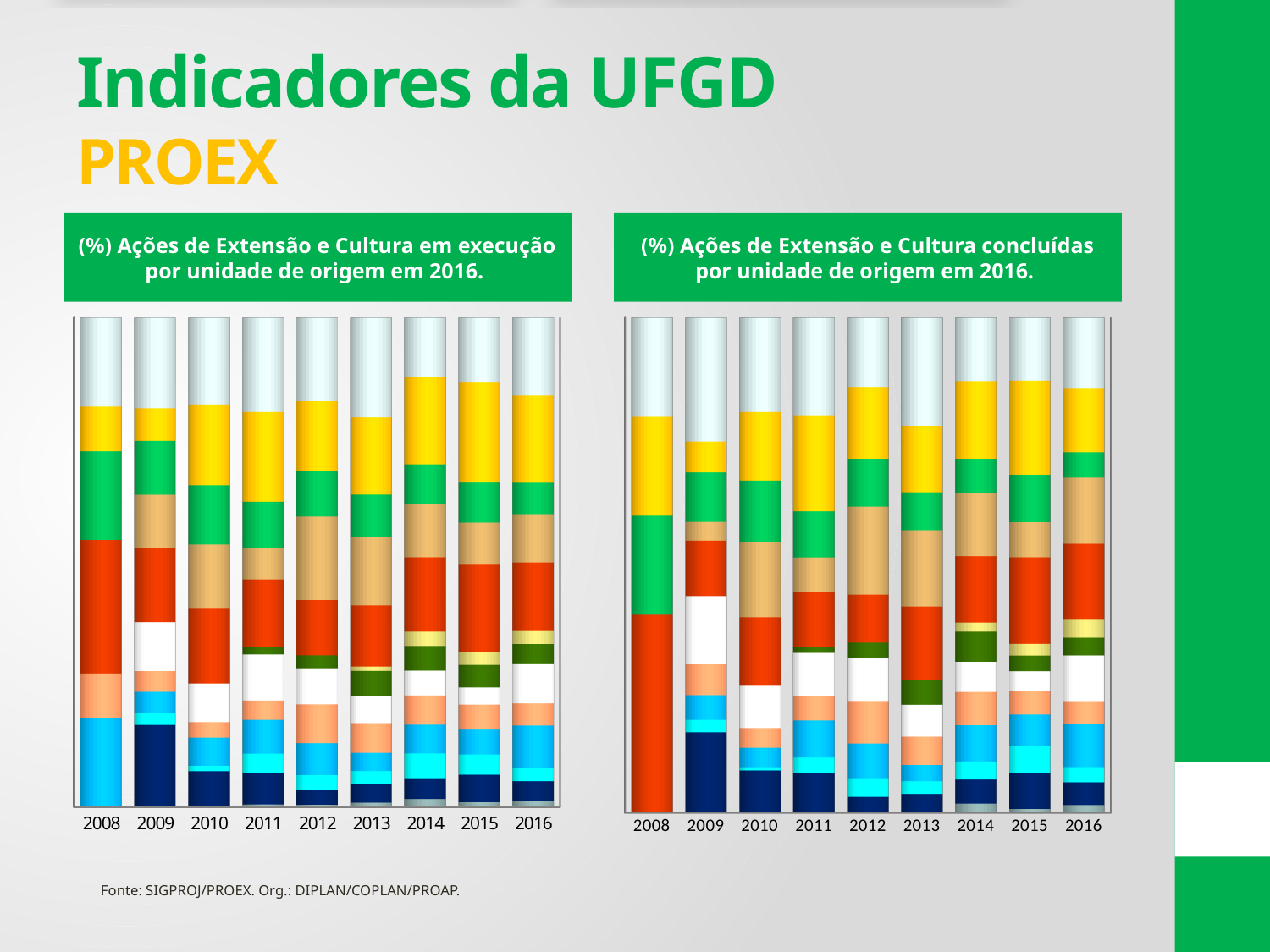
In the right chart, what is the last year shown on the x axis? 2016 In the left chart, how many years are shown on the x axis? 9 In the left chart, what is the first year shown on the x axis? 2008 In the right chart, how many bars are plotted? 9 What is the title of the chart on the left of the slide? (%) Ações de Extensão e Cultura em execução por unidade de origem em 2016. What kind of chart is the right chart, '(%) Ações de Extensão e Cultura concluídas por unidade de origem em 2016'? stacked bar chart What kind of chart is the left chart, '(%) Ações de Extensão e Cultura em execução por unidade de origem em 2016'? stacked bar chart What is the title of the chart on the right of the slide? (%) Ações de Extensão e Cultura concluídas por unidade de origem em 2016.